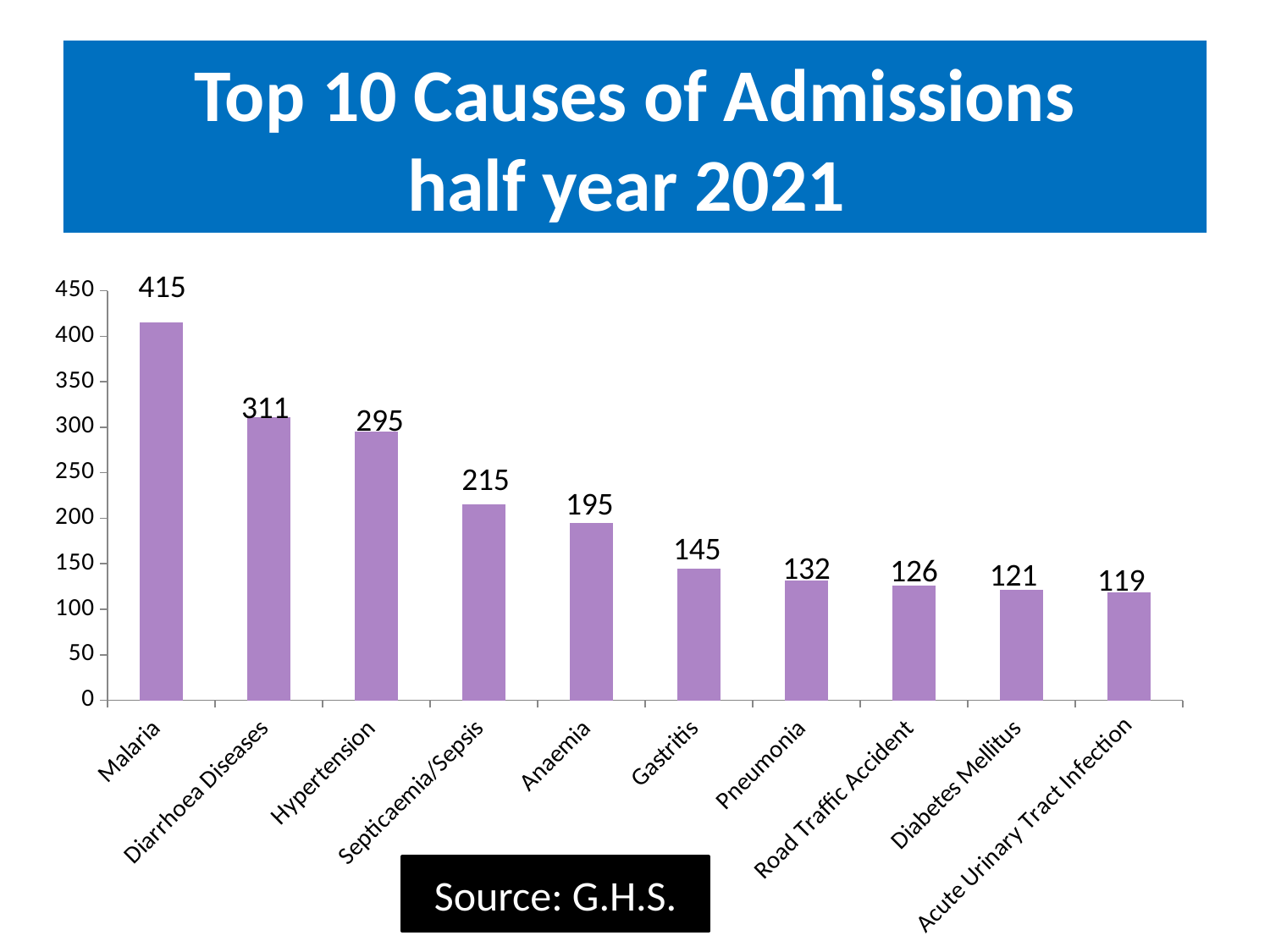
Which cause of admission has the lowest value? Acute Urinary Tract Infection Which is larger, the value for Hypertension or the value for Septicaemia/Sepsis? Hypertension Which cause of admission has the highest value? Malaria Is the value for Pneumonia greater or less than 150? less What is the value for Septicaemia/Sepsis? 215 What kind of chart is shown on the slide? bar chart What is the difference between the values for Malaria and Diarrhoea Diseases? 104 What is the difference between the values for Anaemia and Gastritis? 50 Do the values rise or fall from left to right along the x axis? fall What is the value for Road Traffic Accident? 126 How many causes of admission are shown in the chart? 10 What is the value for Malaria? 415